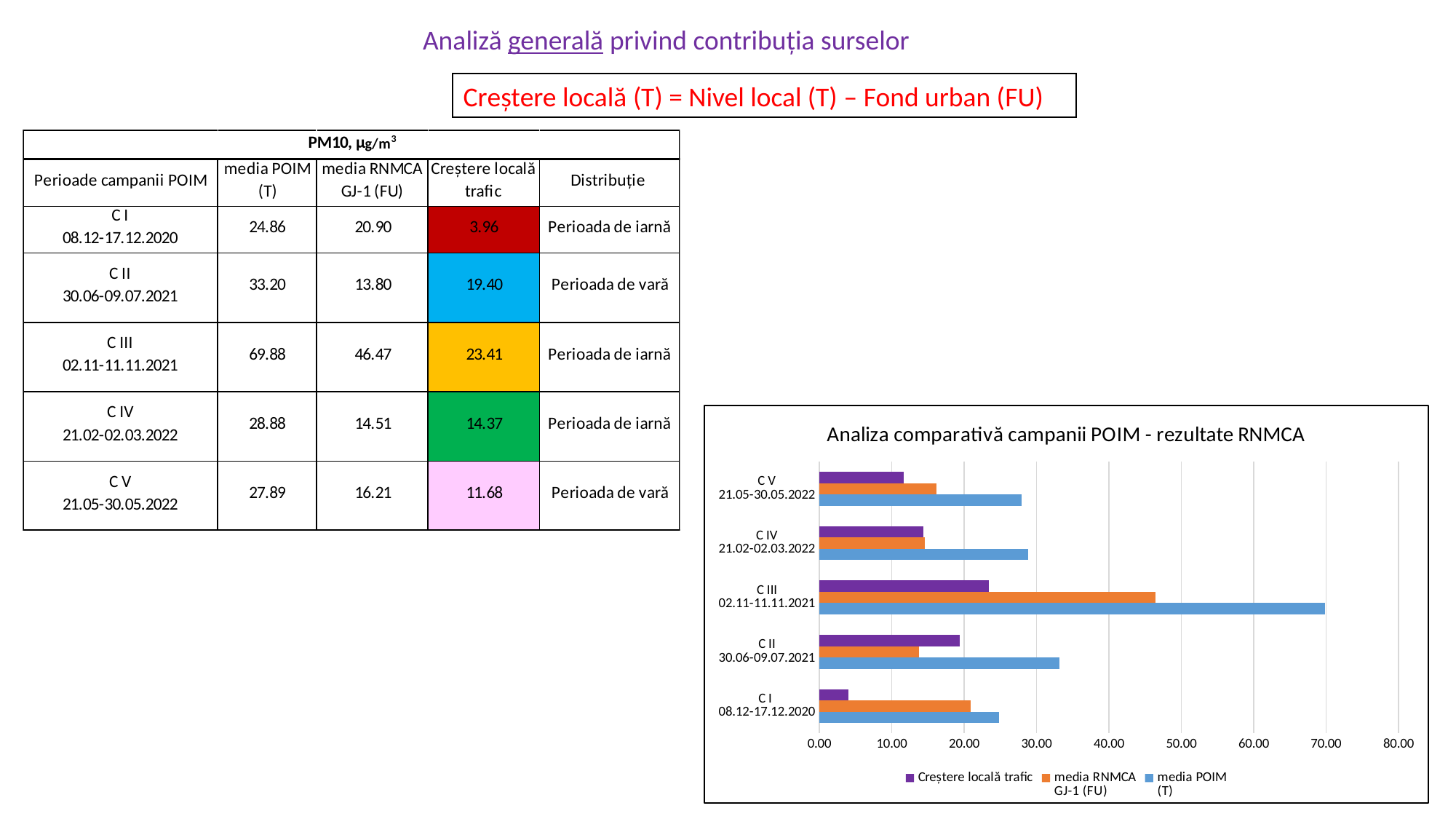
What is the media POIM (T) value for C III 02.11-11.11.2021, as printed in the table on the slide? 69.88 Which campaign has the lowest Creștere locală trafic value in the chart? C I 08.12-17.12.2020 What is the title of the chart on the slide? Analiza comparativă campanii POIM - rezultate RNMCA Is the Creștere locală trafic value for C I 08.12-17.12.2020 greater or less than 10.00? less Which campaign has the highest media POIM (T) value in the chart? C III 02.11-11.11.2021 Which is larger in the chart: the Creștere locală trafic value for C II 30.06-09.07.2021 or for C IV 21.02-02.03.2022? C II 30.06-09.07.2021 Which is larger in the chart: the media POIM (T) value for C II 30.06-09.07.2021 or for C IV 21.02-02.03.2022? C II 30.06-09.07.2021 Is the media POIM (T) value for C III 02.11-11.11.2021 greater or less than 60.00? greater How many series does the chart legend list? 3 How many campaign categories are plotted on the chart? 5 Is the media RNMCA GJ-1 (FU) value for C III 02.11-11.11.2021 greater or less than 40.00? greater What kind of chart is shown on the slide? bar chart